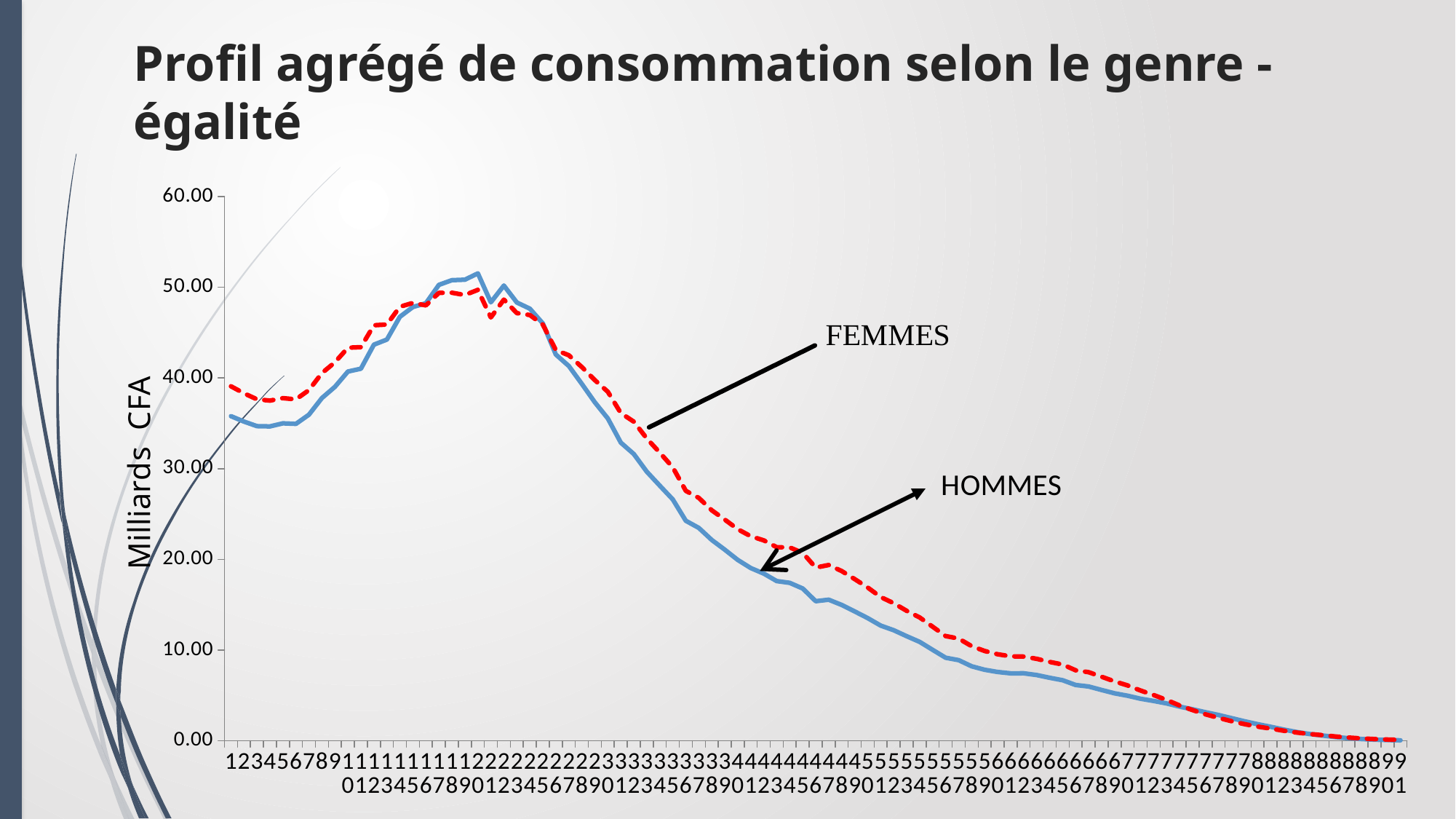
Is the value for FEMMES at age 35 greater or less than 40? less At age 60, which series has the higher value, FEMMES or HOMMES? FEMMES What kind of chart is shown on the slide? line chart Is the value for HOMMES at age 50 greater or less than 20? less Do the values of both series rise or fall between age 30 and age 91? fall What is the label of the vertical axis? Milliards CFA Is the value for HOMMES at age 1 greater or less than 30? greater Which series is drawn as a red dashed line? FEMMES What is the last age label shown on the x axis? 91 How many data series are plotted on the chart? 2 At age 40, which series has the higher value, FEMMES or HOMMES? FEMMES